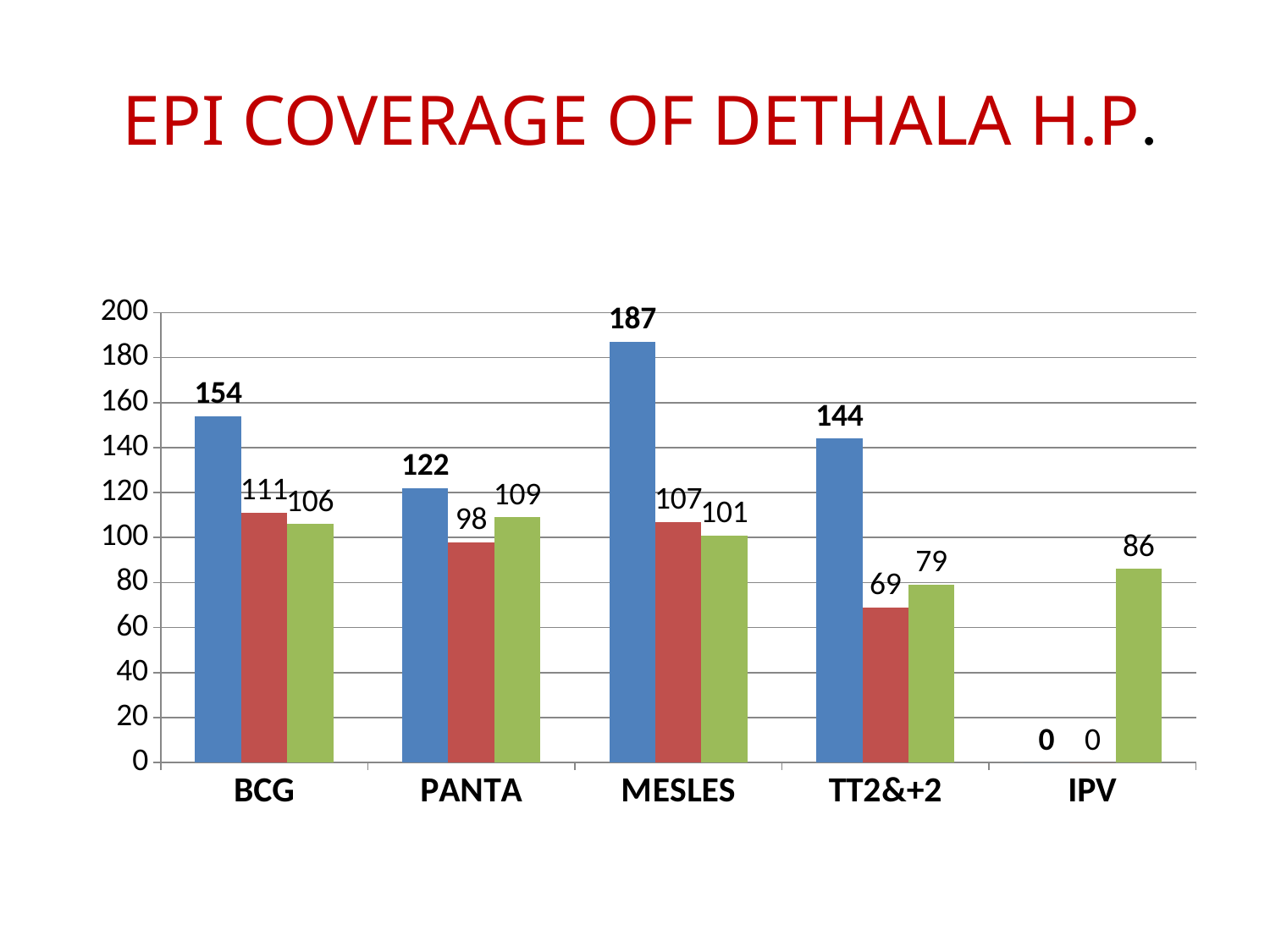
What is the difference between the blue bar for BCG and the blue bar for PANTA? 32 What is the difference between the green bar for TT2&+2 and the red bar for TT2&+2? 10 What is the value of the green bar for IPV? 86 How many categories are shown on the x axis? 5 Which is larger, the red bar for BCG or the green bar for BCG? The red bar for BCG What is the value of the red bar for TT2&+2? 69 Which category has the highest blue bar? MESLES What is the value of the blue bar for MESLES? 187 What is the value of the green bar for PANTA? 109 Which category has the lowest red bar? IPV What is the title of the slide? EPI COVERAGE OF DETHALA H.P. What kind of chart is shown on the slide? Bar chart